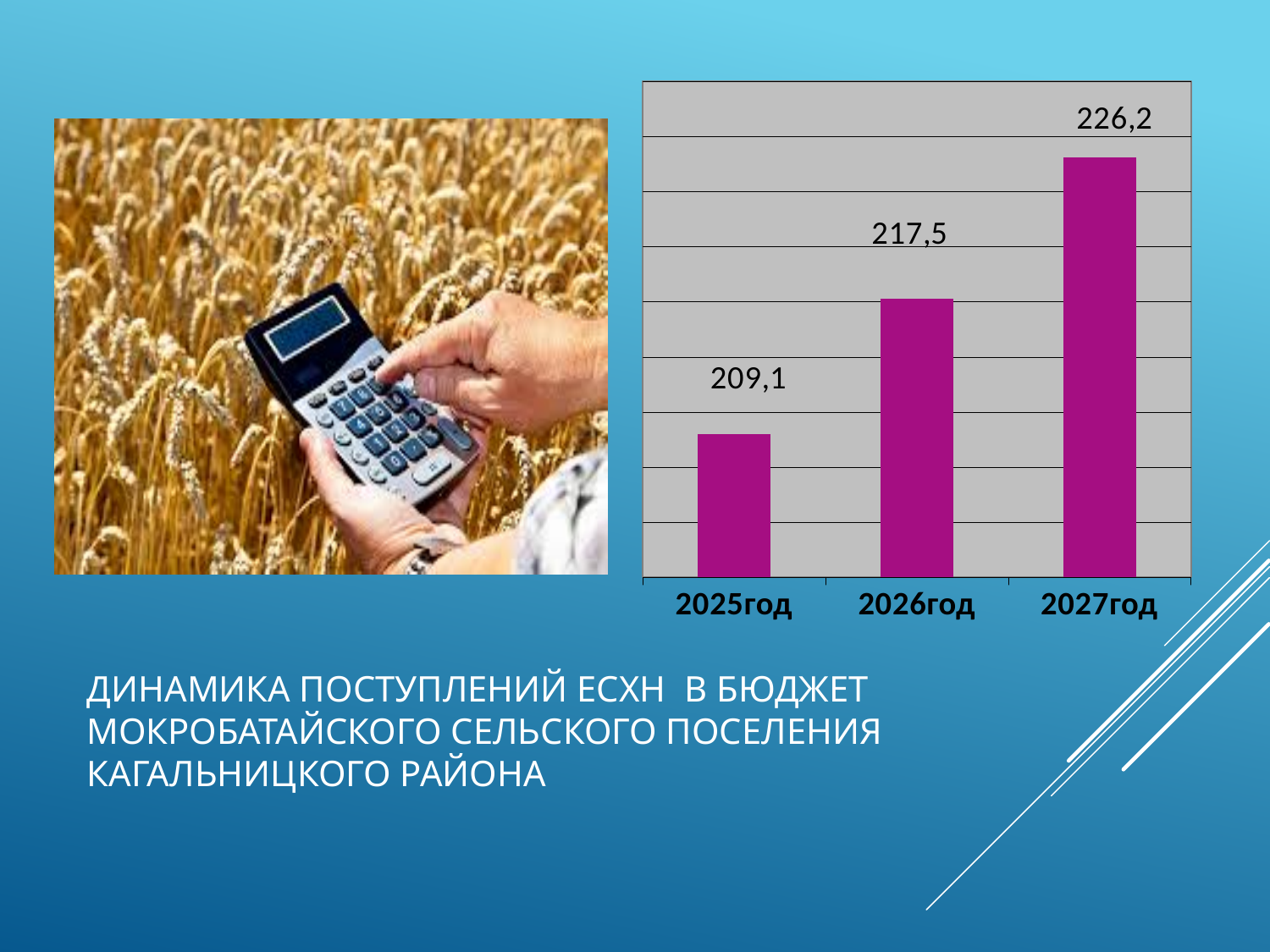
Do the values rise or fall from 2025год to 2027год? Rise What is the value shown for 2027год? 226,2 What is the difference between the values for 2026год and 2025год? 8,4 Which year has the lowest value on the chart? 2025год What is the value shown for 2026год? 217,5 What kind of chart is shown on the slide? Bar chart Which year has the highest value on the chart? 2027год How many years (categories) are shown on the chart? 3 What is the value shown for 2025год? 209,1 Which is larger, the value for 2026год or the value for 2027год? 2027год What is the difference between the values for 2027год and 2026год? 8,7 What is the difference between the values for 2027год and 2025год? 17,1